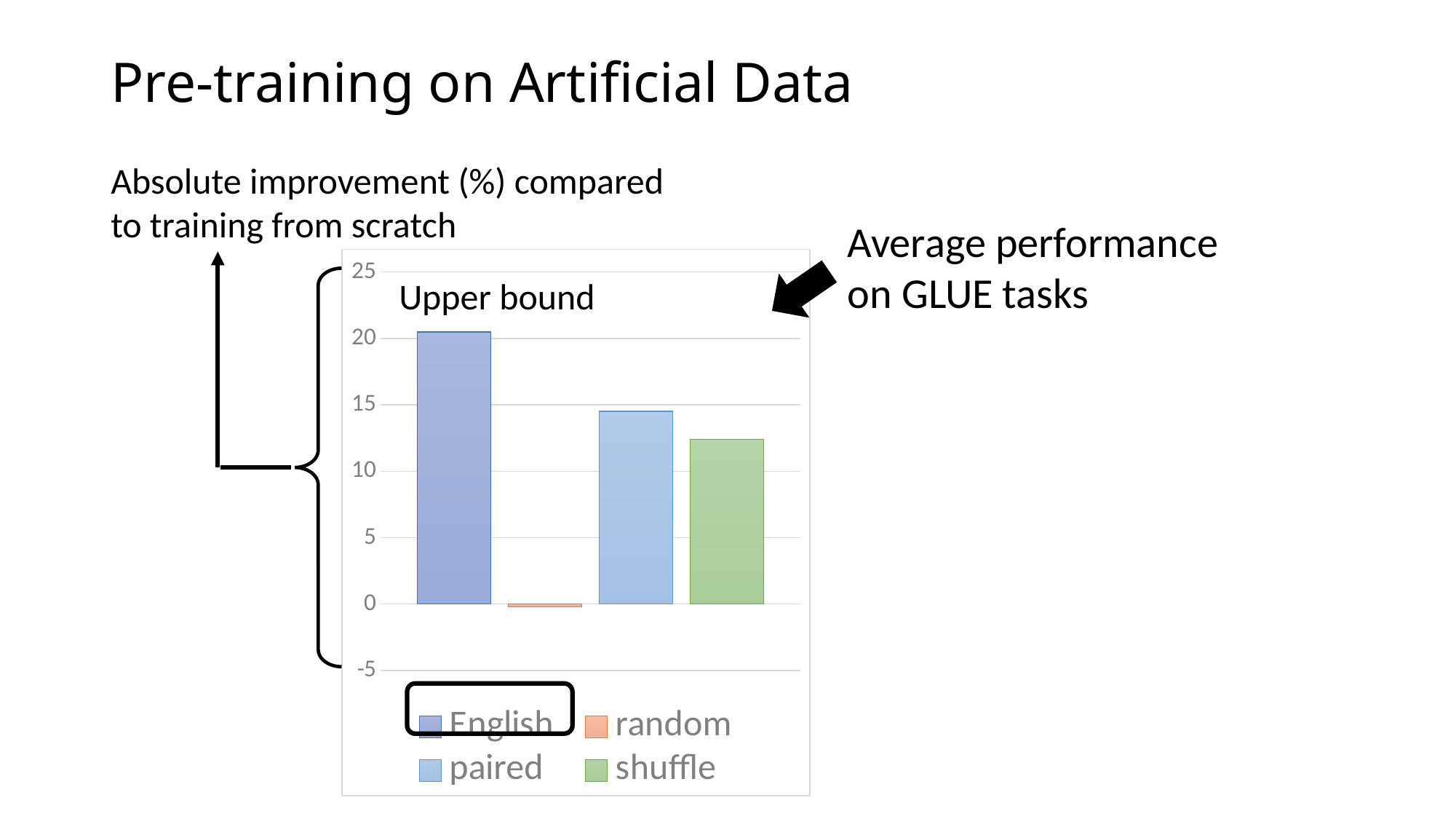
Which series has the lowest value? random Which series has the highest value? English Which is larger, the value for paired or the value for shuffle? paired Is the value for English greater or less than 15? greater Which is larger, the value for English or the value for paired? English Is the value for shuffle greater or less than 15? less Is the value for paired greater or less than 10? greater Which legend entry is circled with a black outline? English How many series does the legend list? 4 How many bars are plotted in the chart? 4 What kind of chart is shown on the slide? bar chart